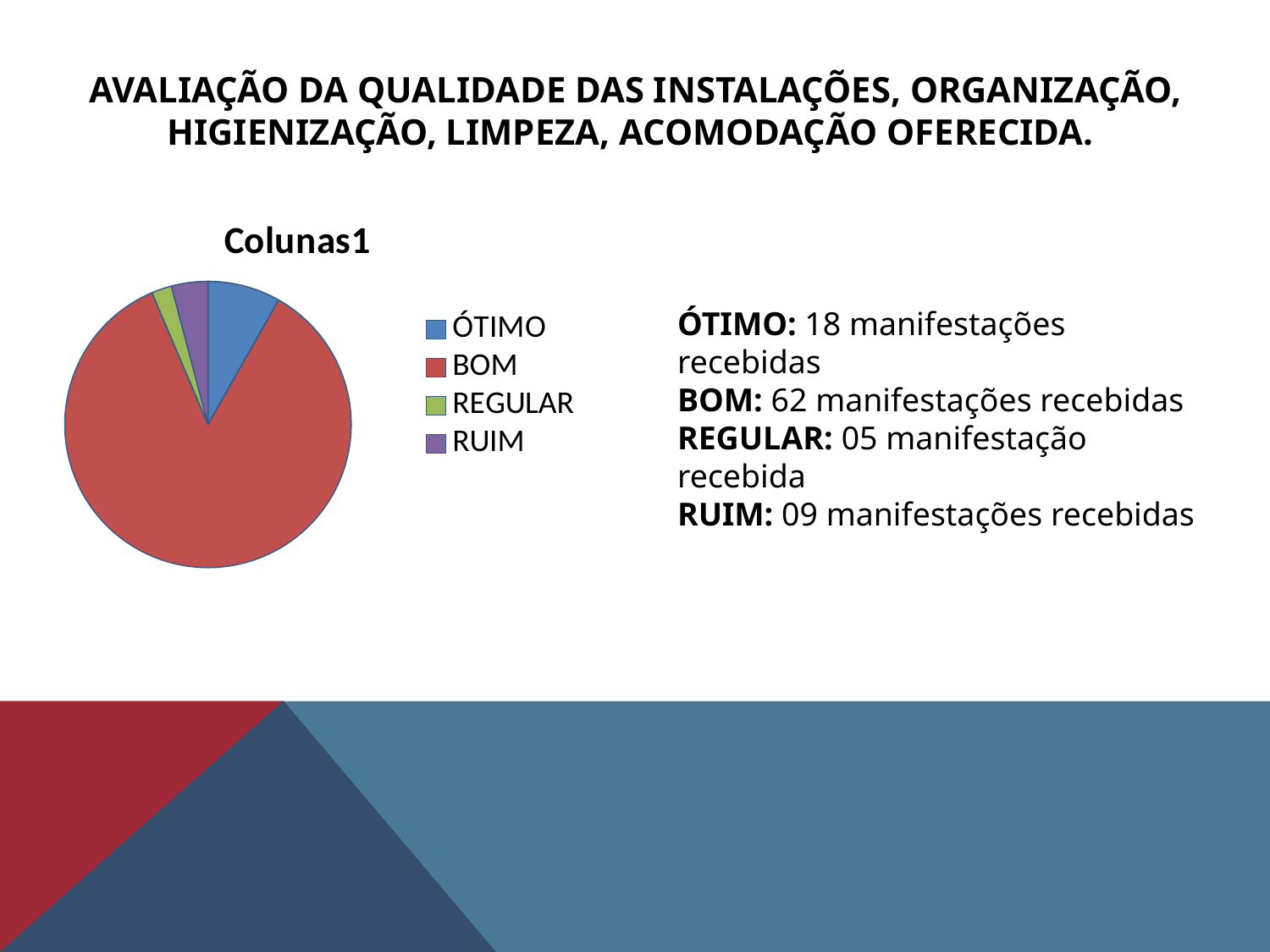
How many categories does the pie chart's legend list? 4 Which category has the largest slice of the pie? BOM Which slice is larger, ÓTIMO or RUIM? ÓTIMO According to the slide, how many manifestações were received for BOM? 62 According to the slide, how many manifestações were received for RUIM? 09 Which slice is larger, RUIM or REGULAR? RUIM What is the difference between the number of manifestações for BOM and for ÓTIMO? 44 What colour is the BOM slice in the pie chart? red What is the title of the chart? Colunas1 What kind of chart is shown on the slide? pie chart Which category has the smallest slice of the pie? REGULAR According to the slide, how many manifestações were received for ÓTIMO? 18